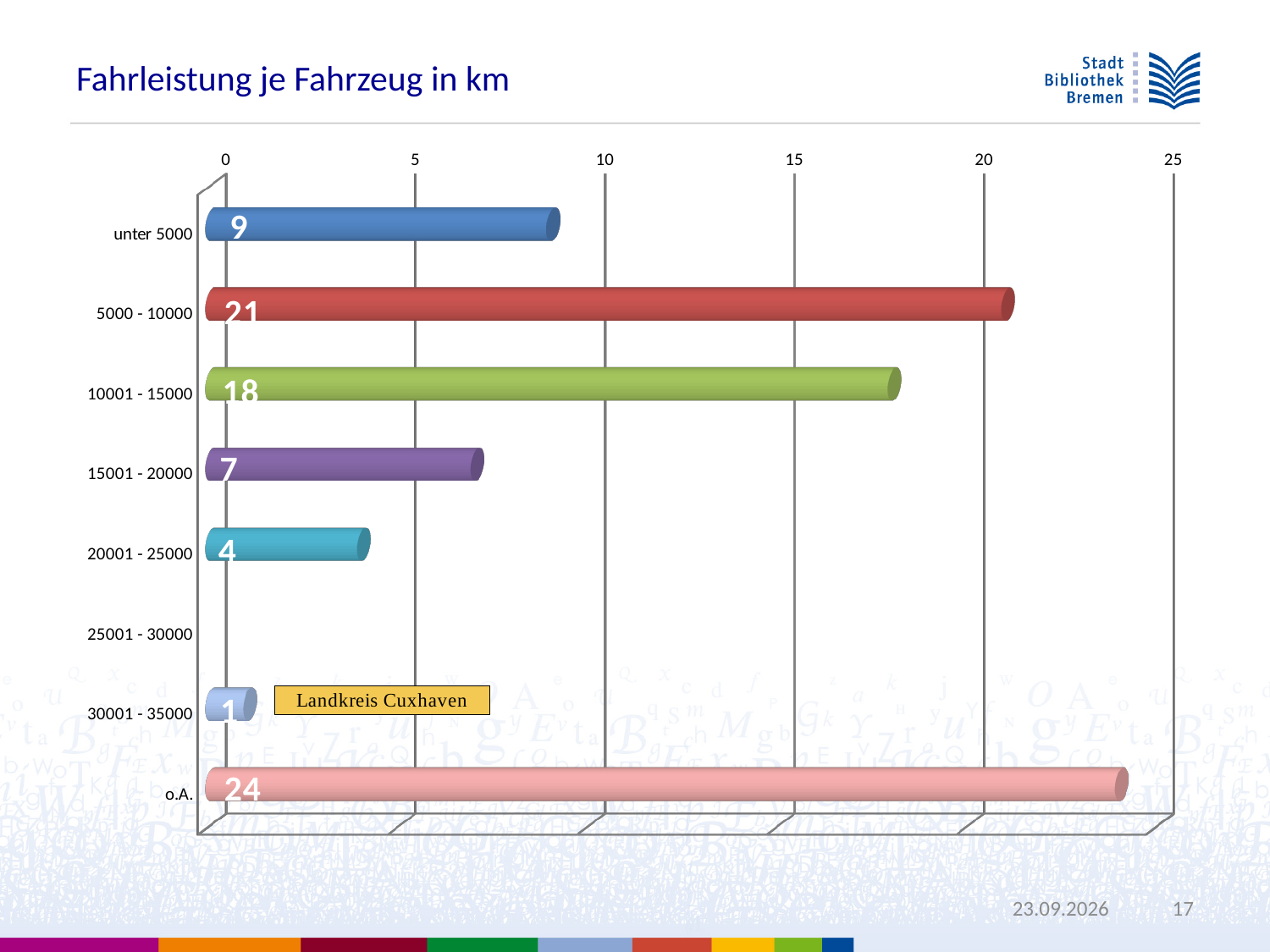
What is the value for the category 'unter 5000'? 9 Which is larger, the value for '10001 - 15000' or the value for '15001 - 20000'? 10001 - 15000 What is the value for the category '5000 - 10000'? 21 Which category has the highest value? o.A. What is the difference between the values for 'unter 5000' and '15001 - 20000'? 2 What is the difference between the values for 'o.A.' and '5000 - 10000'? 3 What is the value for the category '30001 - 35000'? 1 How many categories are shown on the vertical axis? 8 What kind of chart is shown on the slide? bar chart What is the value for the category '10001 - 15000'? 18 Is the value for '20001 - 25000' greater or less than 5? less What is the title of the chart? Fahrleistung je Fahrzeug in km